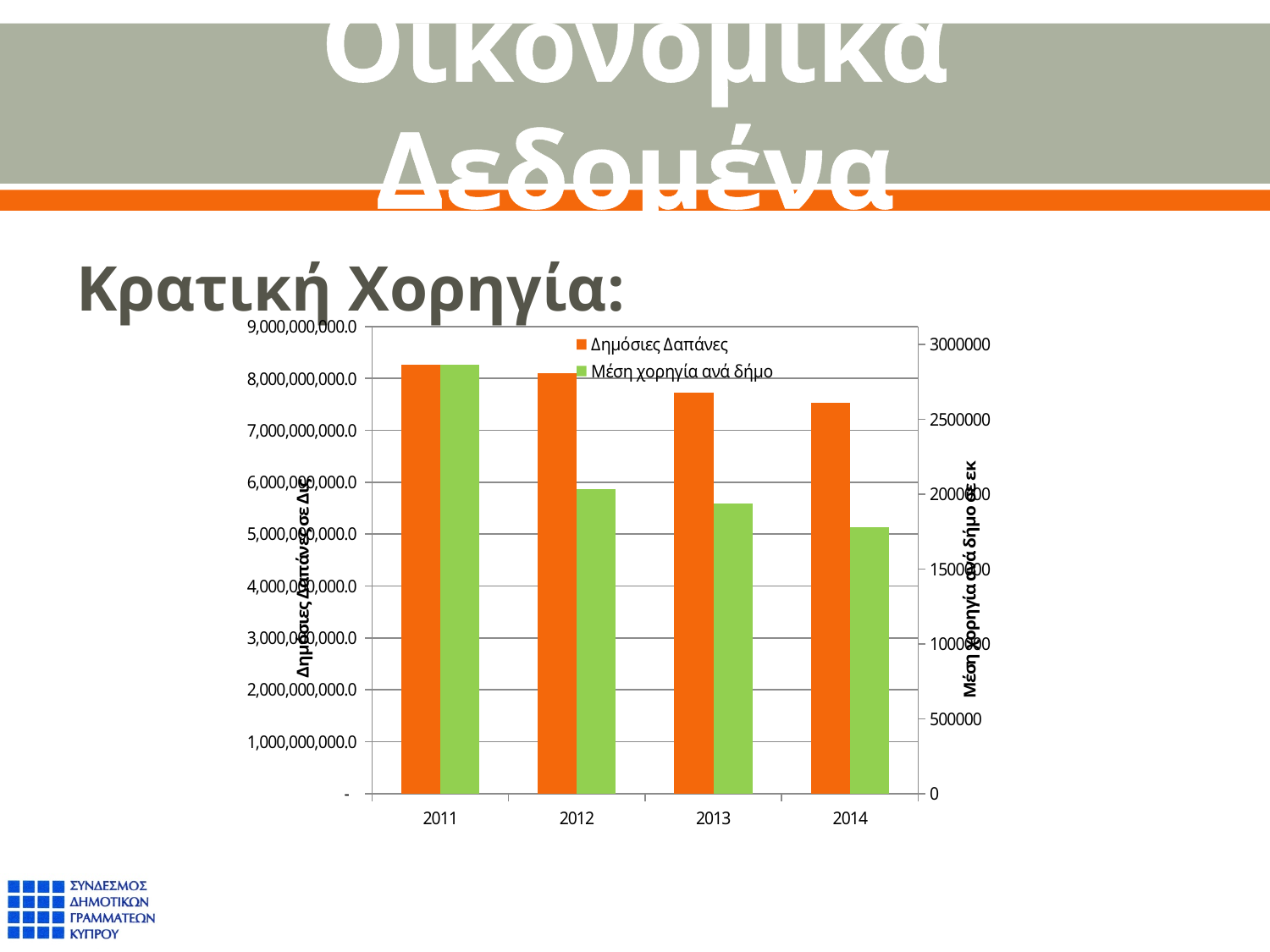
Is the value for Δημόσιες Δαπάνες in 2014 greater or less than 8,000,000,000.0? less Which is larger: Δημόσιες Δαπάνες in 2011 or in 2014? 2011 Which year has the highest value for Δημόσιες Δαπάνες? 2011 Which series is shown in green in the chart? Μέση χορηγία ανά δήμο How many series does the chart's legend list? 2 Is the value for Μέση χορηγία ανά δήμο in 2011 greater or less than 2500000? greater Which year has the lowest value for Μέση χορηγία ανά δήμο? 2014 Do the values for Δημόσιες Δαπάνες rise or fall from 2011 to 2014? fall What kind of chart is shown on the slide? bar chart How many years are shown on the x axis of the chart? 4 Which year has the highest value for Μέση χορηγία ανά δήμο? 2011 Is the value for Δημόσιες Δαπάνες in 2011 greater or less than 8,000,000,000.0? greater